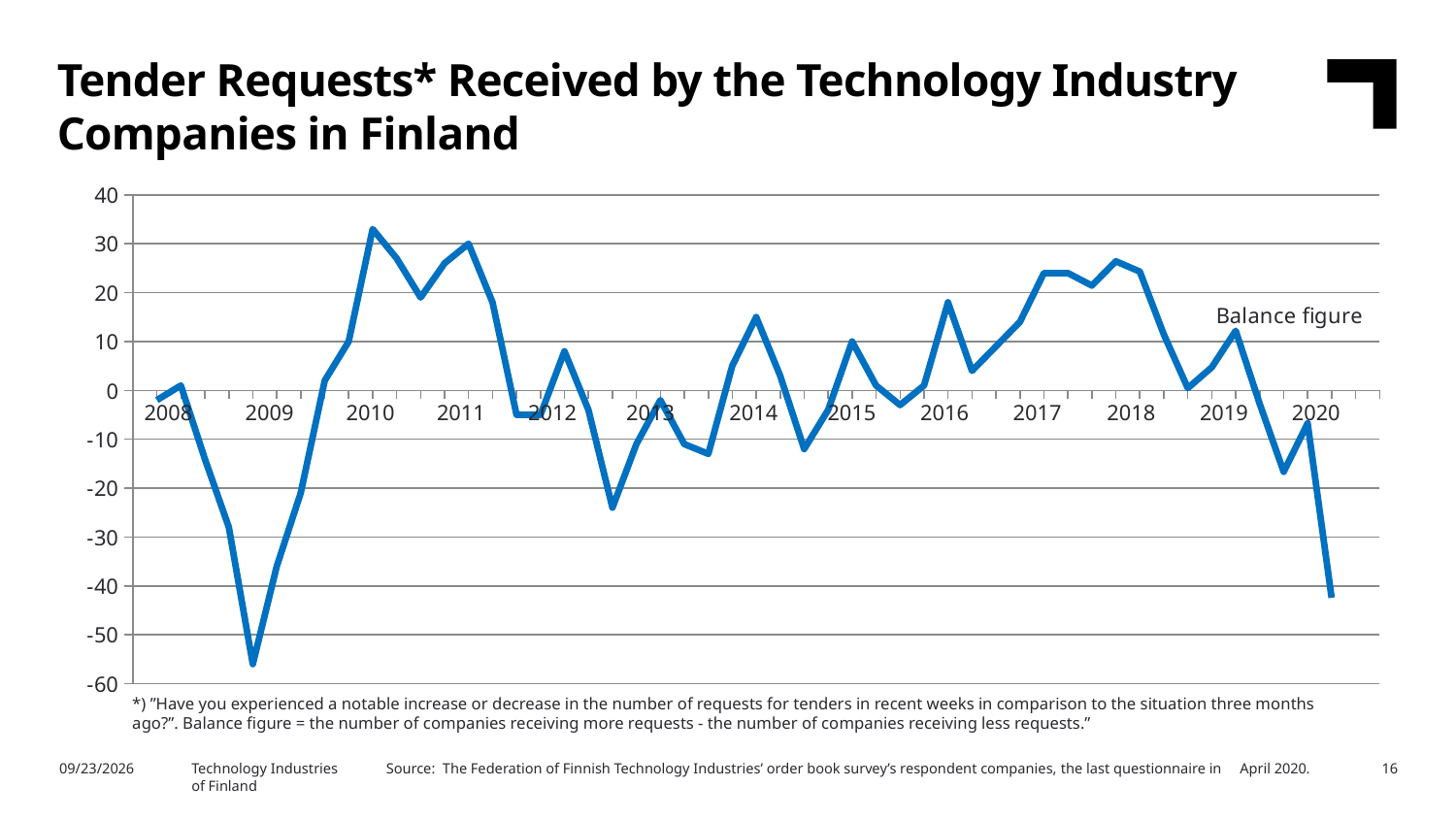
Is the peak value of the line in 2010 greater or less than 30? greater How many years are labelled on the x axis of the chart? 13 What kind of chart is shown on the slide? line chart Which is lower, the low point in 2009 or the low point in 2020? 2009 Is the final value of the line in 2020 greater or less than -40? less In which year does the line reach its lowest value? 2009 Is the low point of the line in 2012 greater or less than -20? less Does the line rise or fall between 2019 and 2020? fall What label is given to the plotted series on the chart? Balance figure What is the title of the chart? Tender Requests* Received by the Technology Industry Companies in Finland